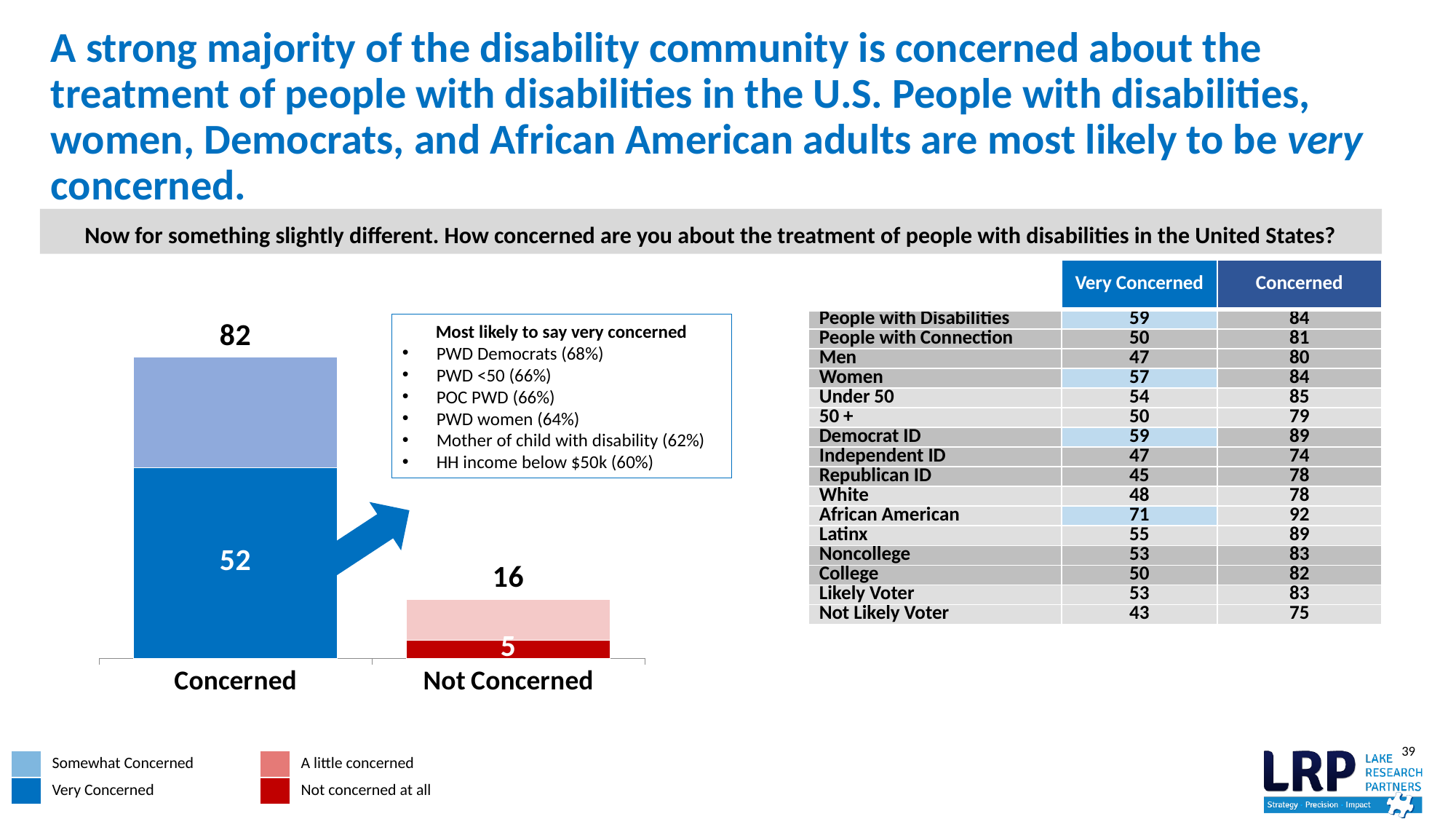
What is the total value shown above the Not Concerned bar? 16 What value is labelled on the Very Concerned segment of the Concerned bar? 52 How many categories are shown on the x axis of the bar chart? 2 Which legend entry is shown in dark blue? Very Concerned Which category has the taller bar, Concerned or Not Concerned? Concerned Is the Very Concerned segment (52) larger or smaller than the Not concerned at all segment (5)? larger How many entries does the legend of the bar chart list? 4 What is the difference between the Very Concerned value (52) and the Not concerned at all value (5)? 47 What value is labelled on the Not concerned at all segment of the Not Concerned bar? 5 What kind of chart is shown on the left of the slide? bar chart What is the total value shown above the Concerned bar? 82 What is the difference between the Concerned total (82) and the Not Concerned total (16)? 66